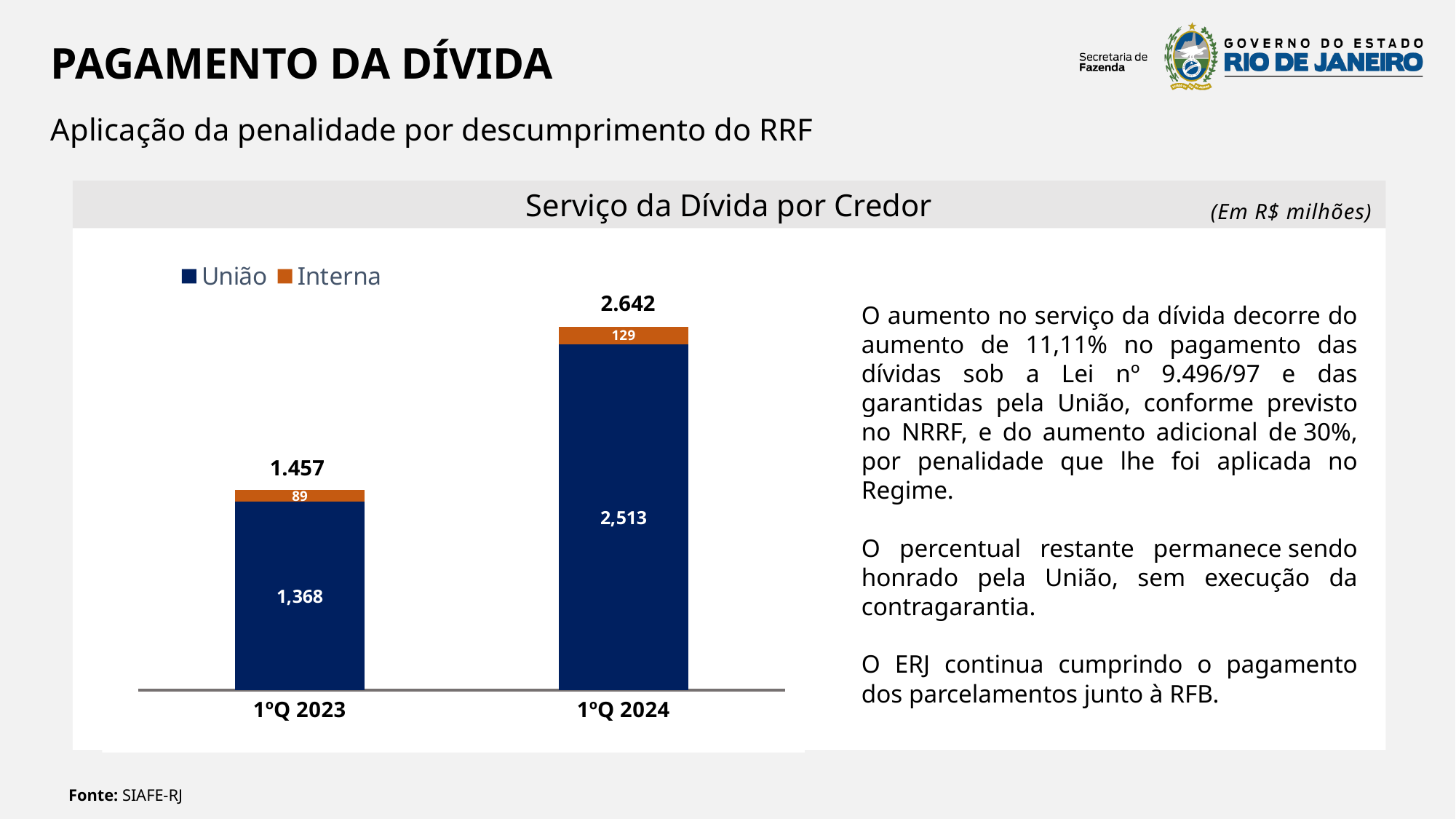
What is the value for União in 1ºQ 2023? 1,368 In what unit are the chart values expressed? R$ milhões What is the total of the stacked bar for 1ºQ 2023? 1.457 How many categories are shown on the x axis? 2 What is the value for Interna in 1ºQ 2023? 89 Which period has the higher total debt service, 1ºQ 2023 or 1ºQ 2024? 1ºQ 2024 What is the value for Interna in 1ºQ 2024? 129 What is the value for União in 1ºQ 2024? 2,513 What type of chart is shown under 'Serviço da Dívida por Credor'? stacked bar chart What is the difference between the Interna values for 1ºQ 2024 and 1ºQ 2023? 40 What is the total of the stacked bar for 1ºQ 2024? 2.642 How many series does the legend list? 2